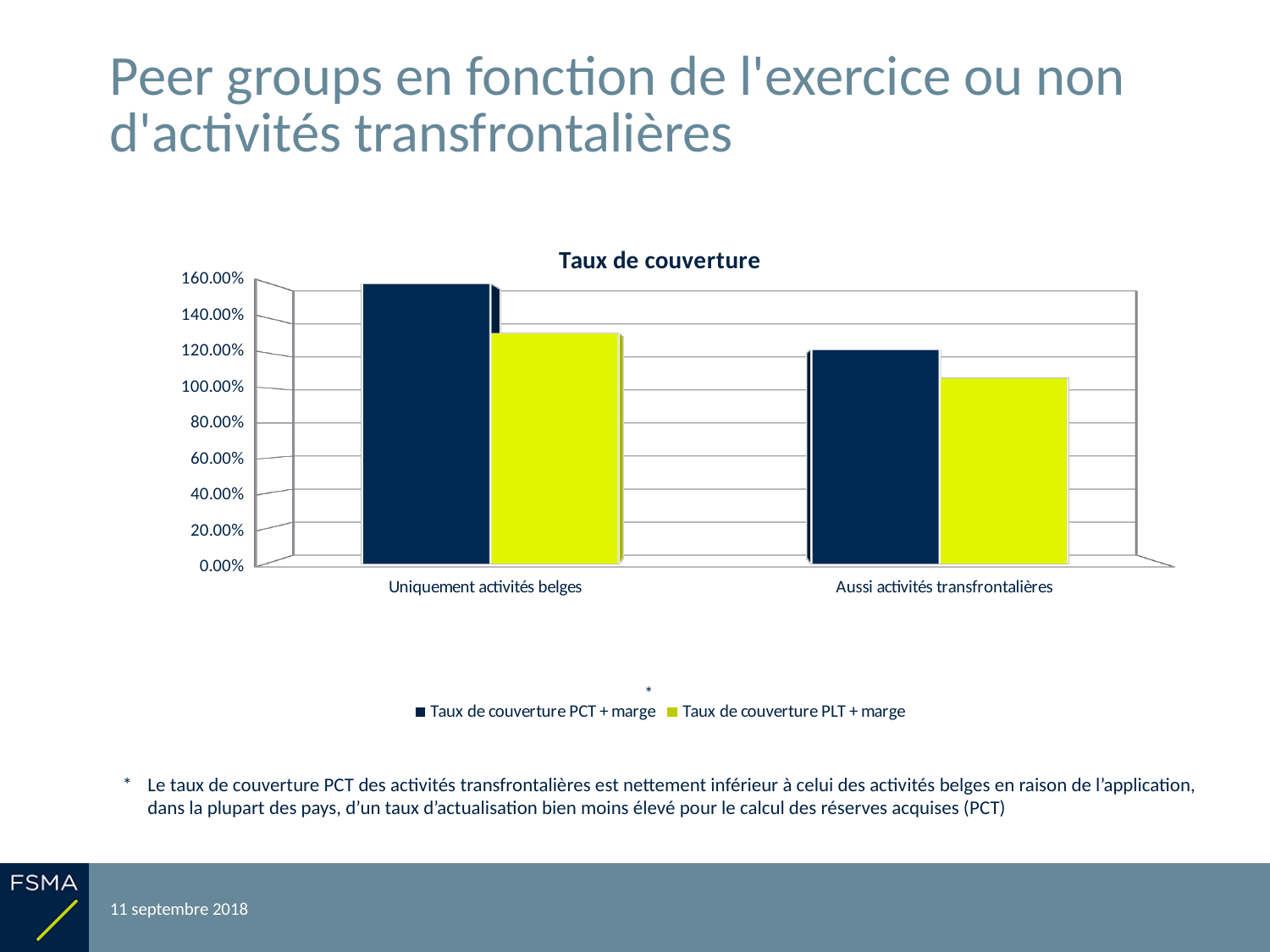
Is the value of Taux de couverture PLT + marge for Uniquement activités belges greater or less than 120.00%? greater Is the value of Taux de couverture PLT + marge for Aussi activités transfrontalières greater or less than 120.00%? less How many series does the legend list? 2 Which series is shown in dark navy? Taux de couverture PCT + marge Is the value of Taux de couverture PCT + marge for Uniquement activités belges greater or less than 140.00%? greater Which category has the highest value for Taux de couverture PCT + marge? Uniquement activités belges How many categories are shown on the x axis? 2 For Aussi activités transfrontalières, which is larger: Taux de couverture PCT + marge or Taux de couverture PLT + marge? Taux de couverture PCT + marge Do the values of Taux de couverture PLT + marge rise or fall from Uniquement activités belges to Aussi activités transfrontalières? fall What type of chart is shown on the slide? bar chart What is the title of the chart? Taux de couverture